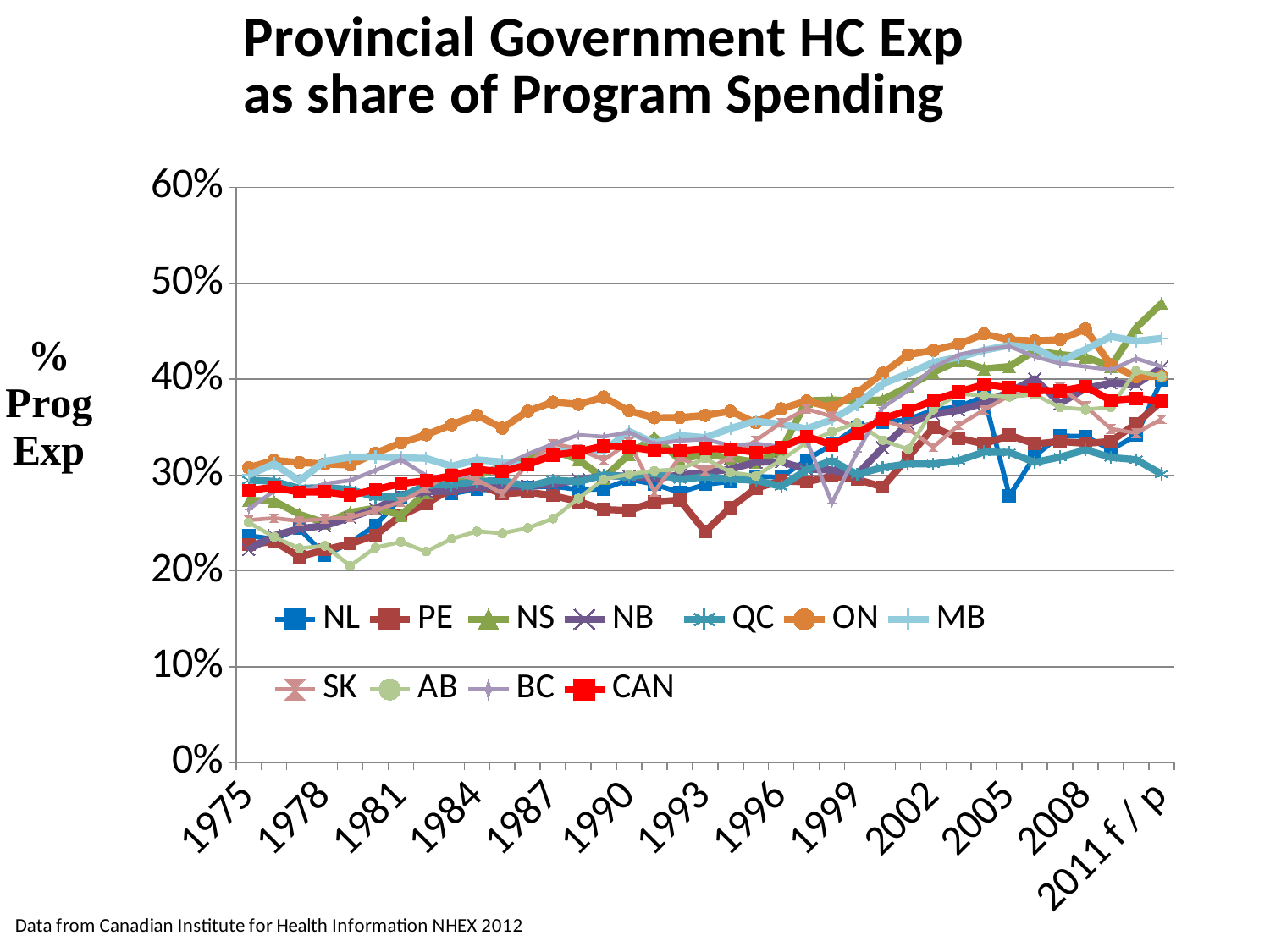
In 2005, which is larger, the value for ON or the value for QC? ON How many series does the legend list? 11 Is the value for CAN in 1975 greater or less than 30%? less Does the CAN series generally rise or fall from 1975 to 2011? rise Which series has the lowest value at 2011 f / p? QC What is the title of the chart? Provincial Government HC Exp as share of Program Spending Is the value for QC at 2011 f / p greater or less than 40%? less Which series has the highest value at 2011 f / p? NS What kind of chart is shown on the slide? line chart Is the value for PE in 1993 greater or less than 30%? less What is the label on the vertical axis? % Prog Exp